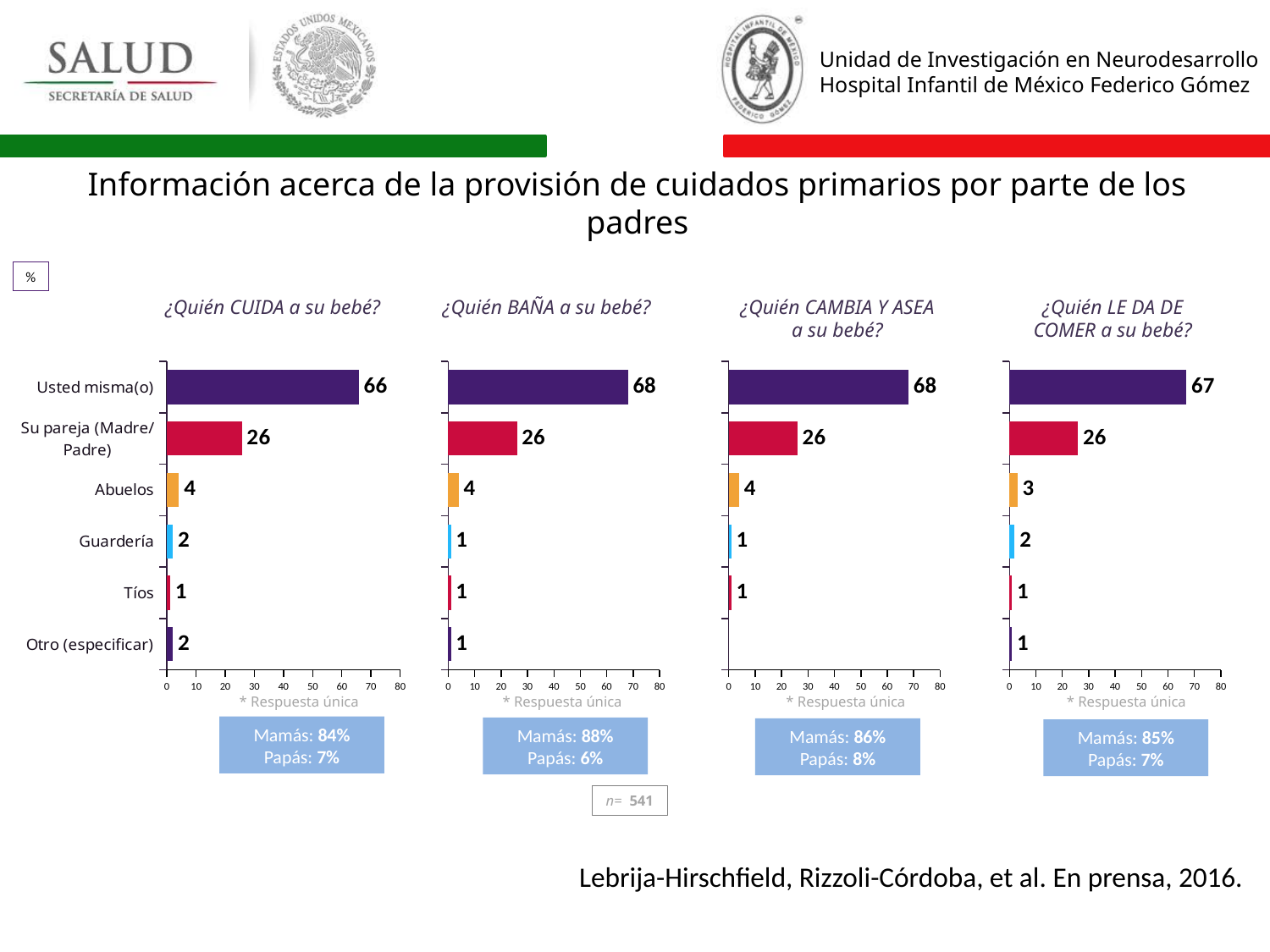
In the '¿Quién BAÑA a su bebé?' chart, what is the value for 'Su pareja (Madre/Padre)'? 26 In the '¿Quién CUIDA a su bebé?' chart, which category has the lowest value? Tíos How many categories does the '¿Quién CUIDA a su bebé?' chart show? 6 What type of chart is used for '¿Quién BAÑA a su bebé?'? bar chart In the '¿Quién CAMBIA Y ASEA a su bebé?' chart, which category has the highest value? Usted misma(o) In the '¿Quién CUIDA a su bebé?' chart, what is the value for 'Usted misma(o)'? 66 How many charts are shown on the slide? 4 In the '¿Quién CAMBIA Y ASEA a su bebé?' chart, is the value for 'Usted misma(o)' greater or less than 60? greater In the '¿Quién CUIDA a su bebé?' chart, what is the value for 'Guardería'? 2 In the '¿Quién LE DA DE COMER a su bebé?' chart, which is larger: 'Guardería' or 'Abuelos'? Abuelos In the '¿Quién LE DA DE COMER a su bebé?' chart, what is the value for 'Abuelos'? 3 In the '¿Quién BAÑA a su bebé?' chart, what is the difference between 'Usted misma(o)' and 'Su pareja (Madre/Padre)'? 42